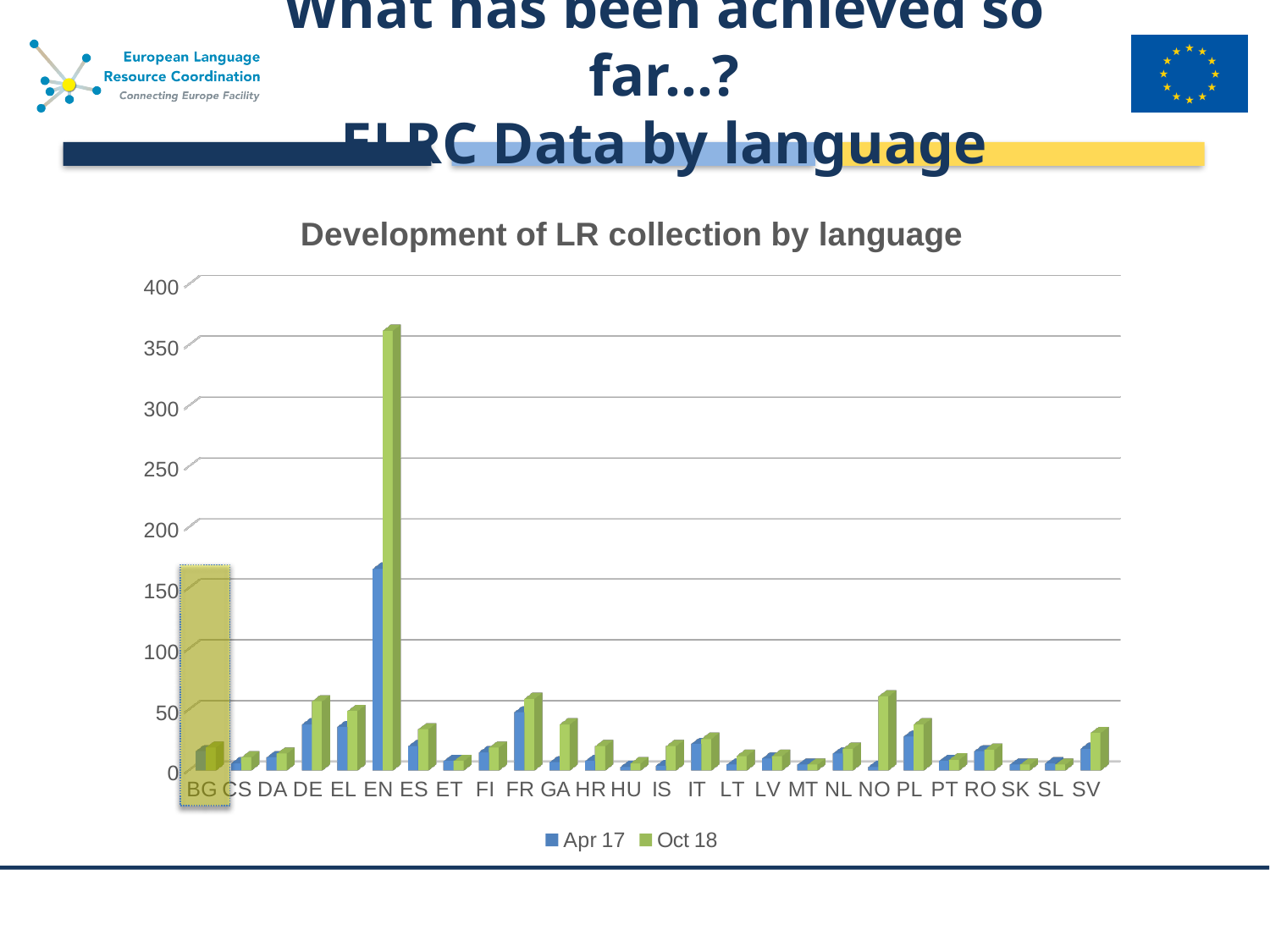
What is the title of the chart? Development of LR collection by language Which is larger, the Oct 18 value for EN or the Oct 18 value for DE? EN Is the Oct 18 value for EN greater or less than 300? greater Which language has the highest Apr 17 value? EN What are the two series named in the legend? Apr 17 and Oct 18 What kind of chart is shown on the slide? bar chart How many series does the legend list? 2 Is the Oct 18 value for HU greater or less than 50? less Which language has the highest Oct 18 value? EN Is the Apr 17 value for EN greater or less than 150? greater Which is larger, the Oct 18 value for NO or the Oct 18 value for MT? NO How many languages are shown on the x axis? 26